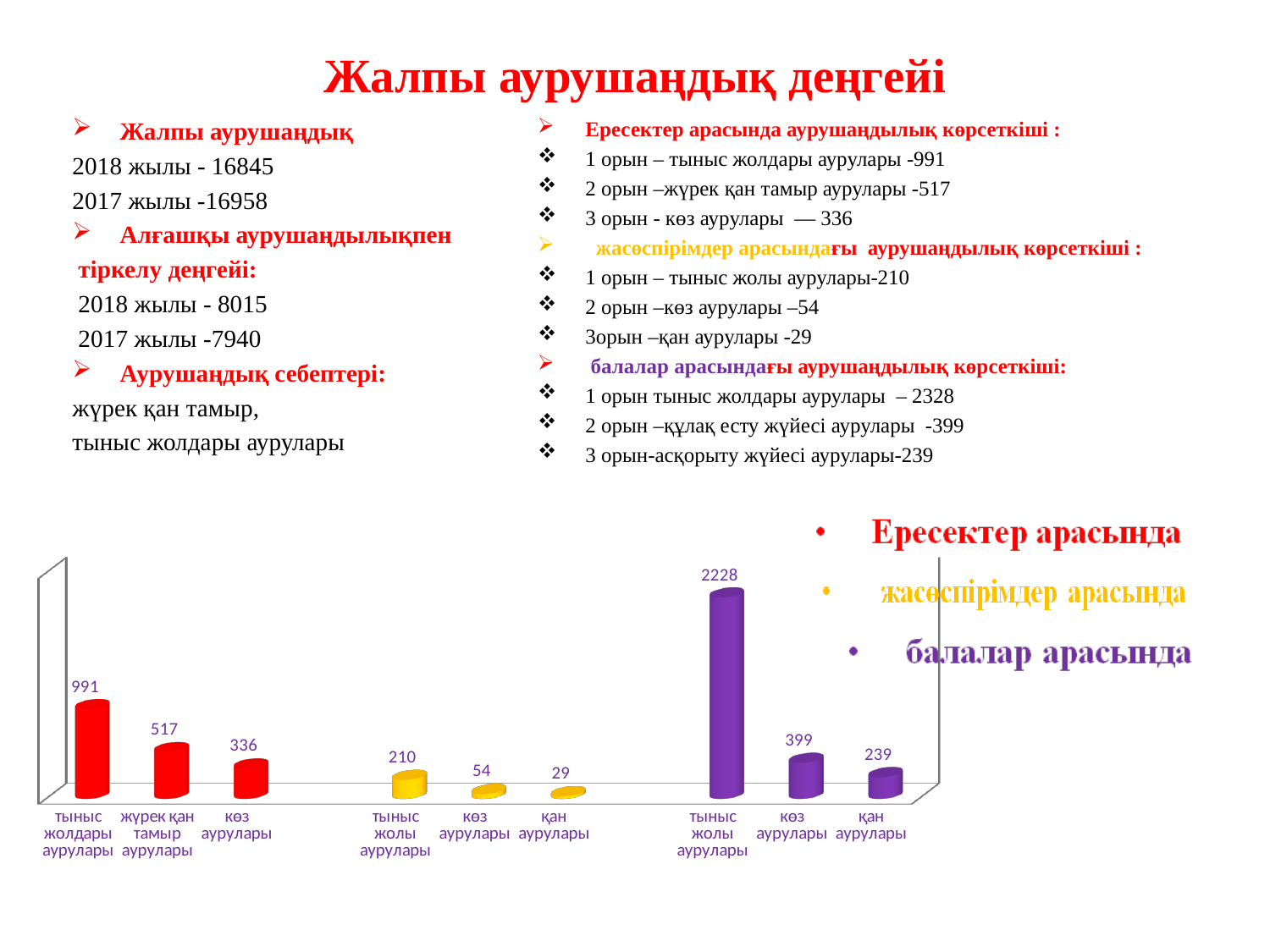
What is the value of the purple bar for тыныс жолы аурулары (балалар арасында)? 2228 What is the value of the yellow bar for тыныс жолы аурулары (жасөспірімдер арасында)? 210 Which bar has the highest value in the chart? тыныс жолы аурулары (балалар арасында), 2228 Which is larger: the purple bar for көз аурулары (балалар арасында) or the red bar for көз аурулары (Ересектер арасында)? purple bar for көз аурулары (балалар арасында), 399 What is the value of the purple bar for қан аурулары (балалар арасында)? 239 What colour are the bars for the Ересектер арасында group? red How many bars are plotted in the chart? 9 What is the value of the red bar for жүрек қан тамыр аурулары (Ересектер арасында)? 517 Which bar has the lowest value in the chart? қан аурулары (жасөспірімдер арасында), 29 What is the value of the red bar for тыныс жолдары аурулары (Ересектер арасында)? 991 What type of chart is shown on the slide? bar chart What is the difference between the red bar for тыныс жолдары аурулары (991) and the red bar for көз аурулары (336)? 655